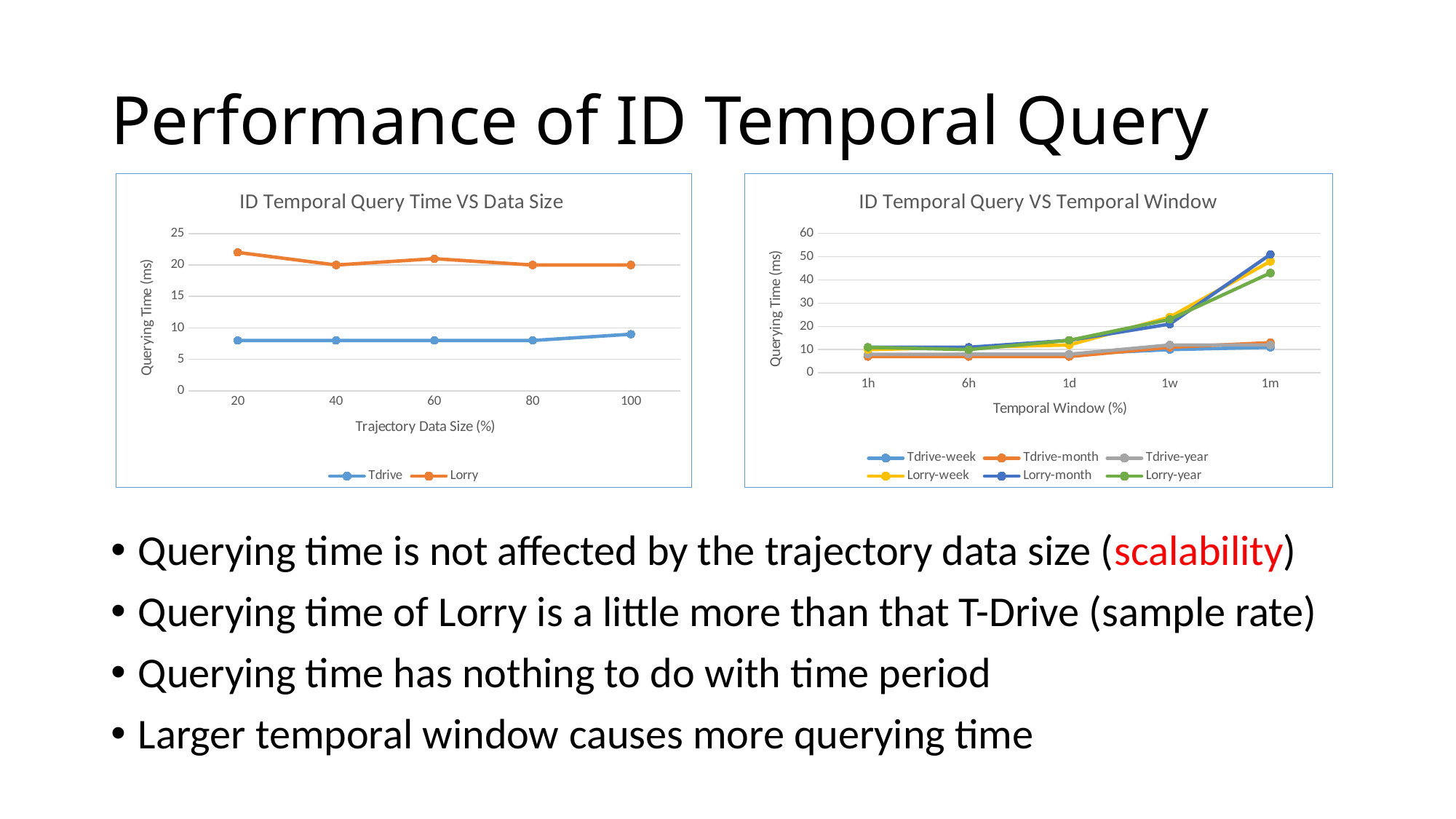
In the chart titled 'ID Temporal Query VS Temporal Window', which series has the highest querying time at 1m? Lorry-month In the chart titled 'ID Temporal Query Time VS Data Size', is the value for Lorry at a data size of 60 greater or less than 15? greater In the chart titled 'ID Temporal Query VS Temporal Window', how many series does the legend list? 6 In the chart titled 'ID Temporal Query Time VS Data Size', which series has the higher querying time at a data size of 20? Lorry In the chart titled 'ID Temporal Query Time VS Data Size', what kind of chart is shown? line chart In the chart titled 'ID Temporal Query VS Temporal Window', what is the x-axis title? Temporal Window (%) In the chart titled 'ID Temporal Query Time VS Data Size', how many data size values are plotted along the x axis? 5 In the chart titled 'ID Temporal Query VS Temporal Window', is the value for Lorry-month at 1m greater or less than 40? greater In the chart titled 'ID Temporal Query VS Temporal Window', how many temporal window categories are on the x axis? 5 In the chart titled 'ID Temporal Query Time VS Data Size', how many series does the legend list? 2 In the chart titled 'ID Temporal Query Time VS Data Size', does the Lorry line rise or fall from a data size of 20 to 40? fall In the chart titled 'ID Temporal Query Time VS Data Size', is the value for Tdrive at a data size of 40 greater or less than 10? less